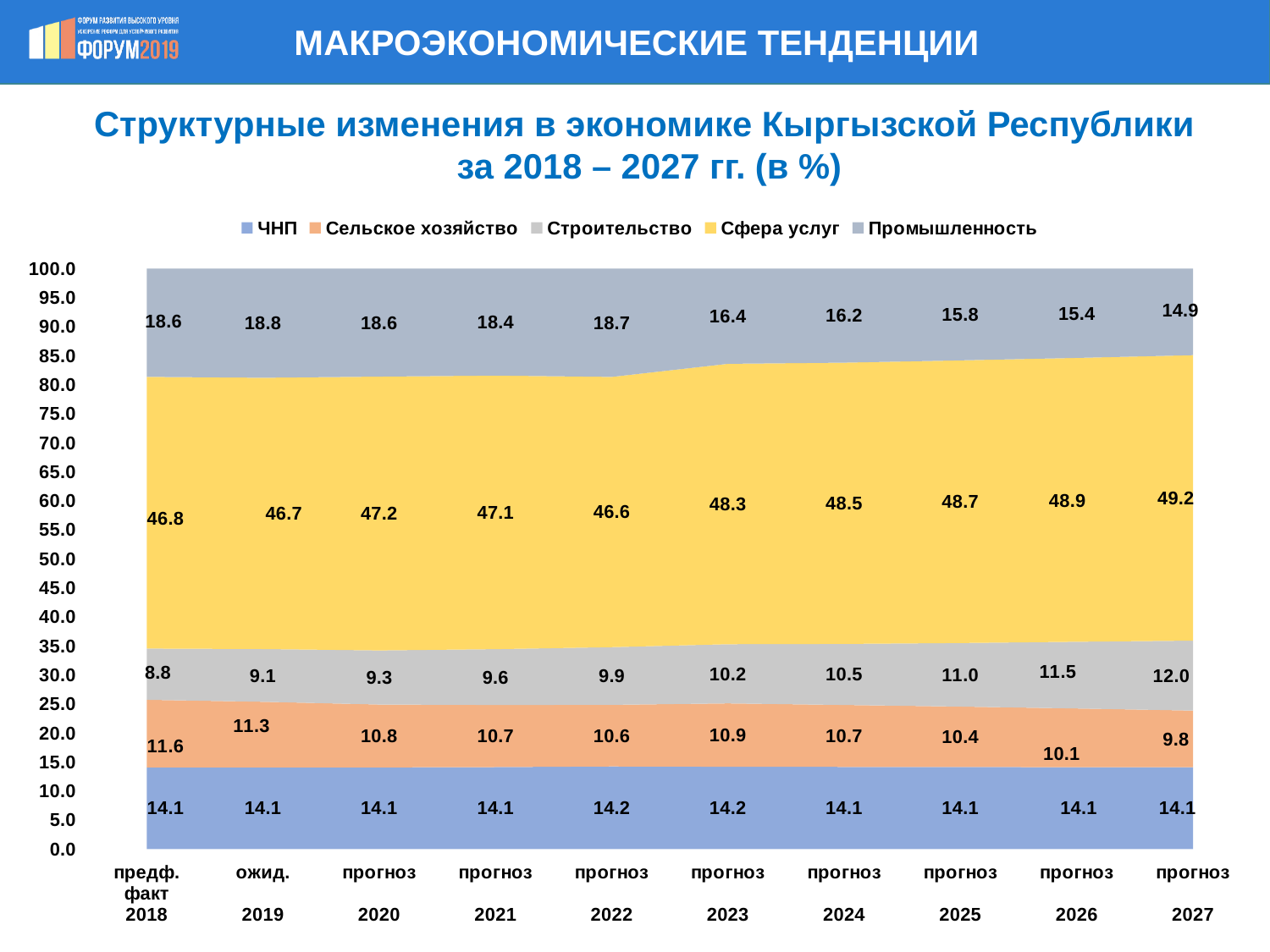
Does the value for Строительство rise or fall from 2018 to 2027? Rises What is the difference between the Сфера услуг values in 2027 and 2018? 2.4 What is the value for Сельское хозяйство in 2026? 10.1 How many years are shown along the x axis? 10 Which is larger in 2022: the value for Сельское хозяйство or the value for Строительство? Сельское хозяйство What is the value for Строительство in 2023? 10.2 What is the value for Промышленность in 2018? 18.6 What is the value for Сфера услуг in 2027? 49.2 How many series does the legend list? 5 What kind of chart is shown on the slide? Stacked area chart In which year is the value for Промышленность lowest? 2027 In which year is the value for Строительство highest? 2027